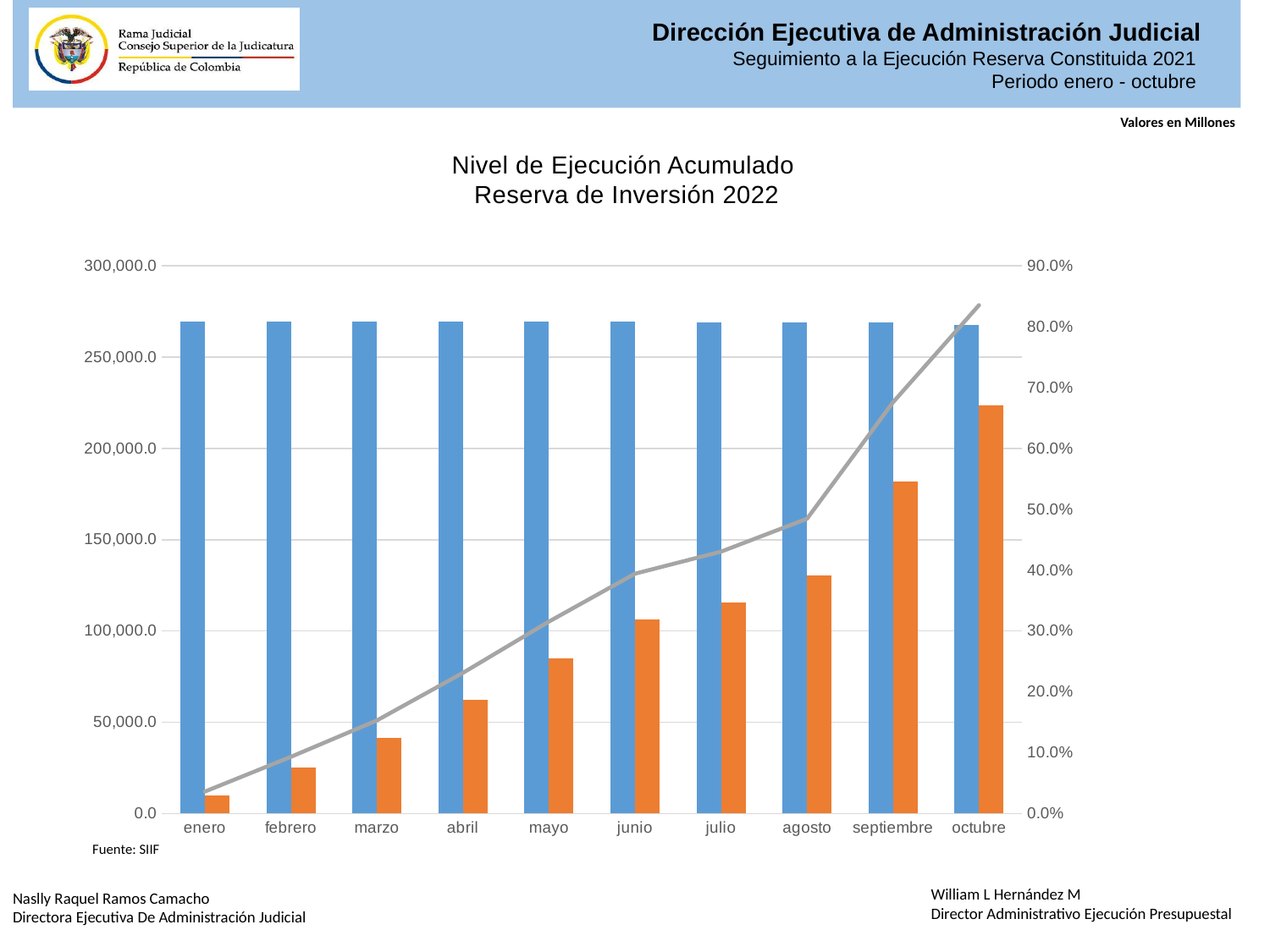
Is the orange bar for octubre greater or less than 200,000.0? greater Which month has the shortest orange bar? enero Is the gray line value for octubre greater or less than 80.0%? greater Is the blue bar for marzo greater or less than 250,000.0? greater In octubre, which bar is taller, the blue bar or the orange bar? The blue bar Which month has the tallest orange bar? octubre What type of chart is shown on the slide? Combined bar and line chart How many months are shown on the x axis of the chart? 10 Do the orange bars rise or fall from enero to octubre? Rise What is the title of the chart? Nivel de Ejecución Acumulado Reserva de Inversión 2022